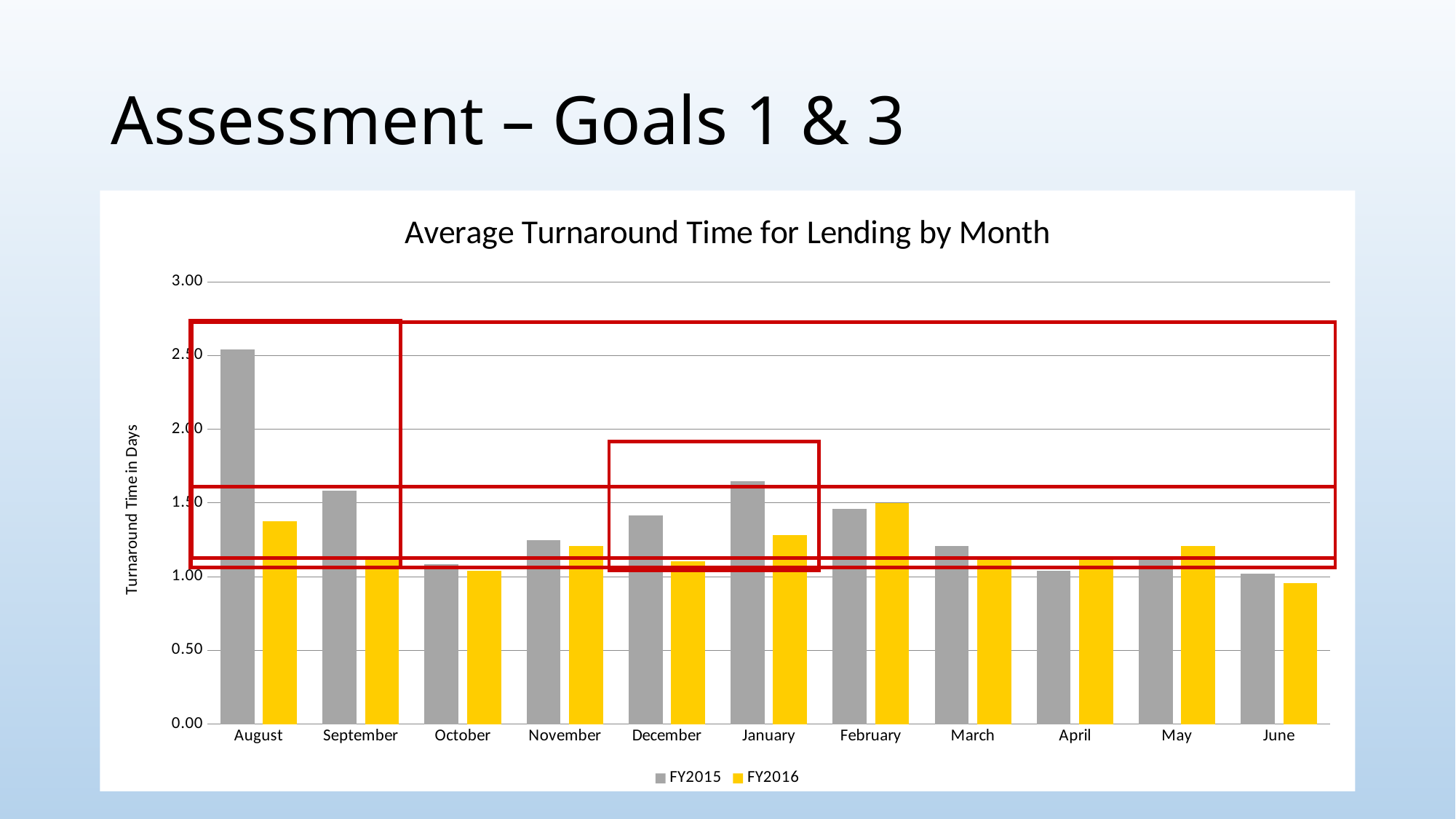
Which month has the highest FY2015 turnaround time? August Is the FY2015 value for August greater or less than 2.00? greater Is the FY2015 value for January greater or less than 1.50? greater What is the label on the vertical axis? Turnaround Time in Days What kind of chart is shown on the slide? Bar chart Is the FY2016 value for June greater or less than 1.00? less Which month has the lowest FY2016 turnaround time? June How many months are shown on the x axis? 11 How many series does the legend list? 2 What is the title of the chart? Average Turnaround Time for Lending by Month Which month has the highest FY2016 turnaround time? February In August, which series has the larger value, FY2015 or FY2016? FY2015